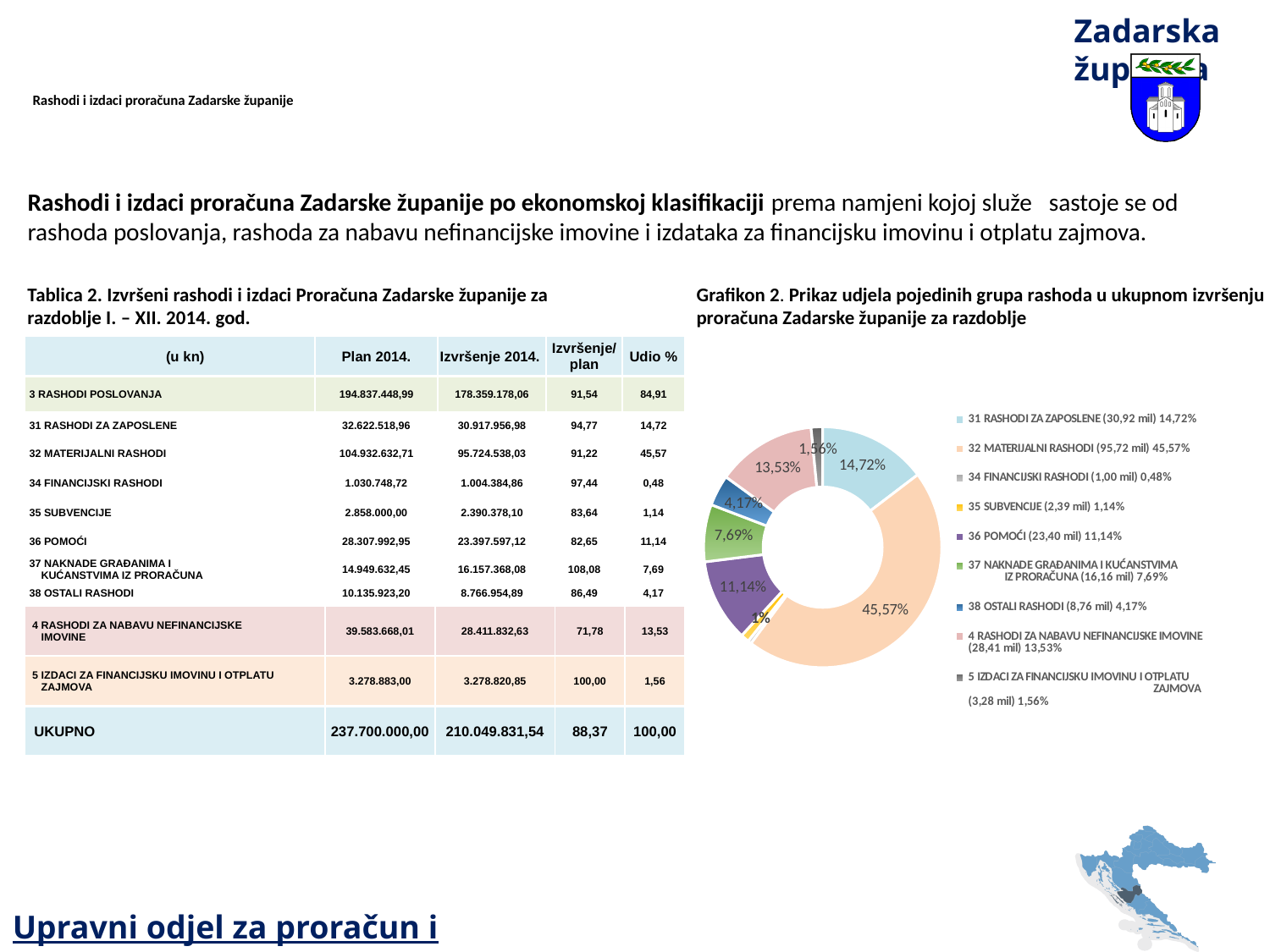
In Grafikon 2, how many slices (categories) does the chart show? 9 In Grafikon 2, what share does 31 RASHODI ZA ZAPOSLENE have? 14,72% In Grafikon 2, what amount in millions is shown in the legend for 5 IZDACI ZA FINANCIJSKU IMOVINU I OTPLATU ZAJMOVA? 3,28 mil In Grafikon 2, what share does 36 POMOĆI have? 11,14% What kind of chart is Grafikon 2? Doughnut (pie) chart In Grafikon 2, which has the larger share: 36 POMOĆI or 37 NAKNADE GRAĐANIMA I KUĆANSTVIMA IZ PRORAČUNA? 36 POMOĆI In Grafikon 2, what share does 38 OSTALI RASHODI have? 4,17% In Grafikon 2, which category has the smallest share according to the legend? 34 FINANCIJSKI RASHODI In Grafikon 2, which category has the largest share? 32 MATERIJALNI RASHODI In Grafikon 2, what is the difference in share between 32 MATERIJALNI RASHODI and 31 RASHODI ZA ZAPOSLENE? 30,85%